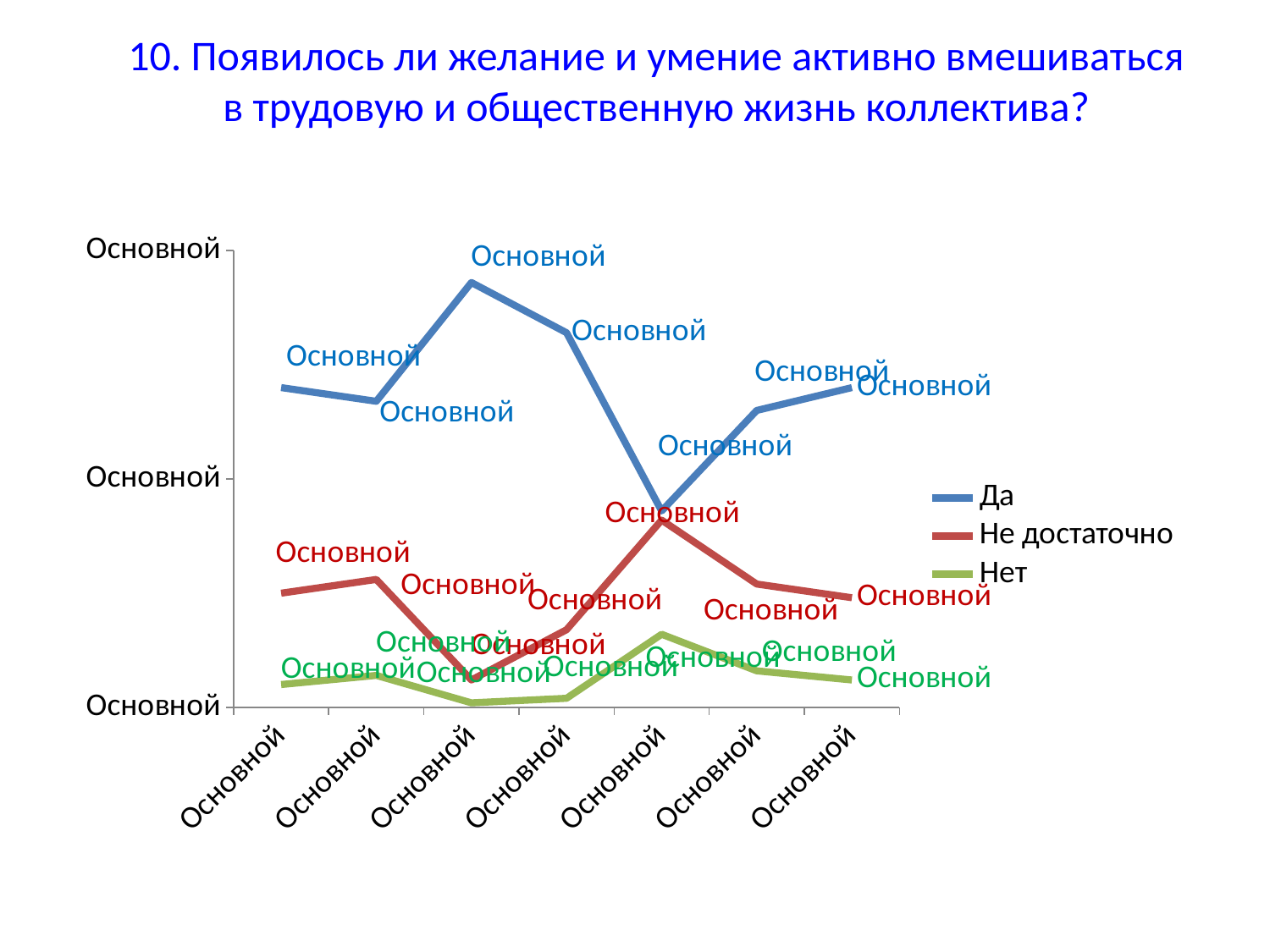
How many series does the legend list? 3 Does the "Не достаточно" line rise or fall from the third point to the fifth point? rise What colour is the line for the series "Да"? blue How many points are plotted along the x axis for each series? 7 At the first point on the x axis, which is larger: "Да" or "Не достаточно"? Да Which series reaches the highest value on the chart? Да What are the three entries in the chart legend? Да, Не достаточно, Нет Does the "Да" line rise or fall from the fifth point to the sixth point? rise Which series stays lowest across the chart? Нет At the last point on the x axis, which is larger: "Не достаточно" or "Нет"? Не достаточно Does the "Да" line rise or fall from the third point to the fifth point? fall What kind of chart is shown on the slide? line chart